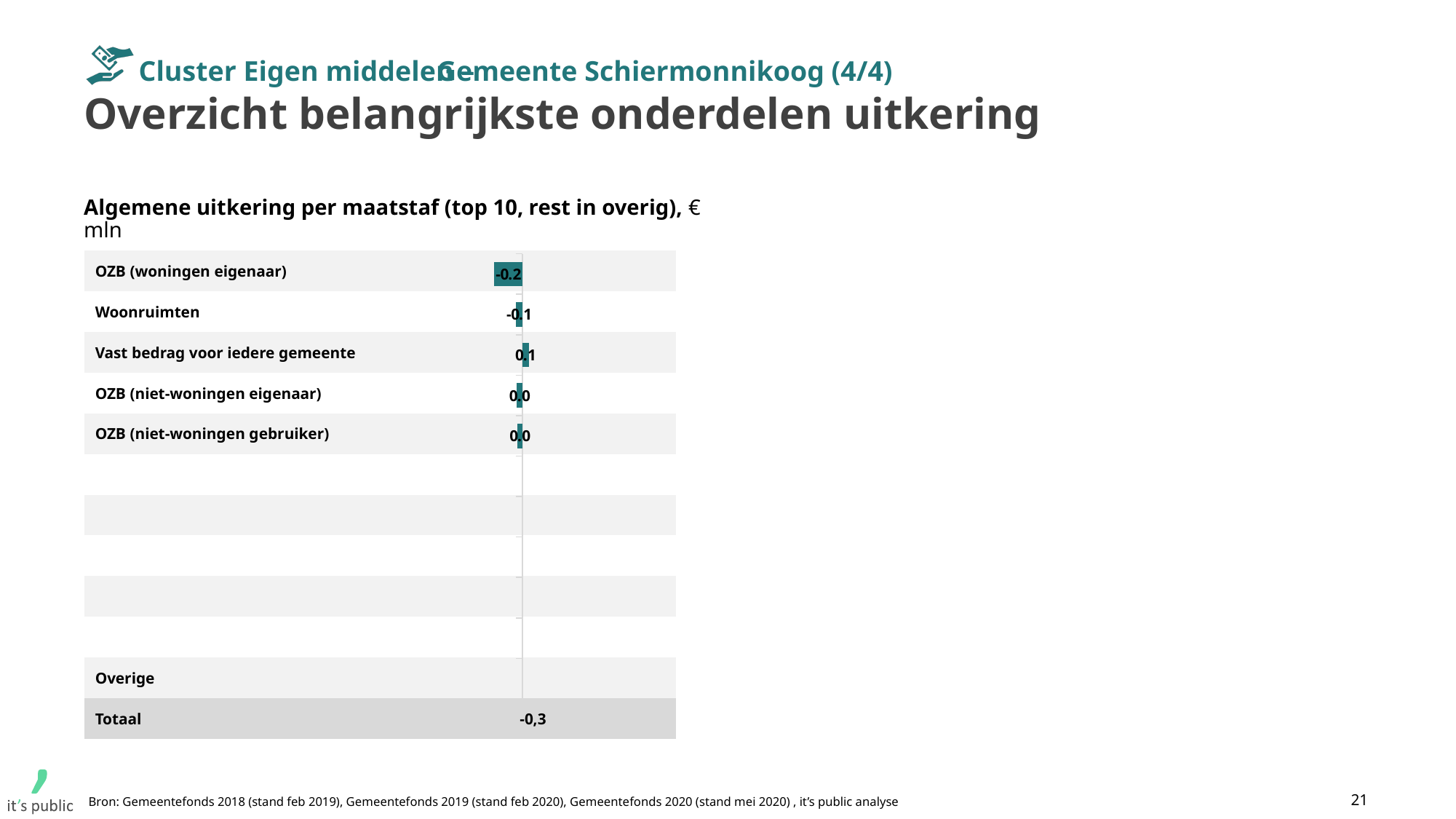
What is the difference between the values for Vast bedrag voor iedere gemeente and OZB (woningen eigenaar)? 0.3 What value is shown for Totaal at the bottom of the chart? -0,3 How many categories with a plotted bar and data label are shown in the chart (excluding Overige and Totaal)? 5 What is the value for Vast bedrag voor iedere gemeente in the chart? 0.1 What is the value for OZB (niet-woningen eigenaar) in the chart? 0.0 What kind of chart is shown on the slide? Bar chart Which is larger, the value for Woonruimten or the value for Vast bedrag voor iedere gemeente? Vast bedrag voor iedere gemeente Which labelled category has the highest value in the chart? Vast bedrag voor iedere gemeente In what unit are the values in the chart expressed, according to the chart title? € mln What is the value for Woonruimten in the chart? -0.1 What is the value for OZB (woningen eigenaar) in the chart 'Algemene uitkering per maatstaf'? -0.2 Which labelled category has the lowest (most negative) value in the chart? OZB (woningen eigenaar)